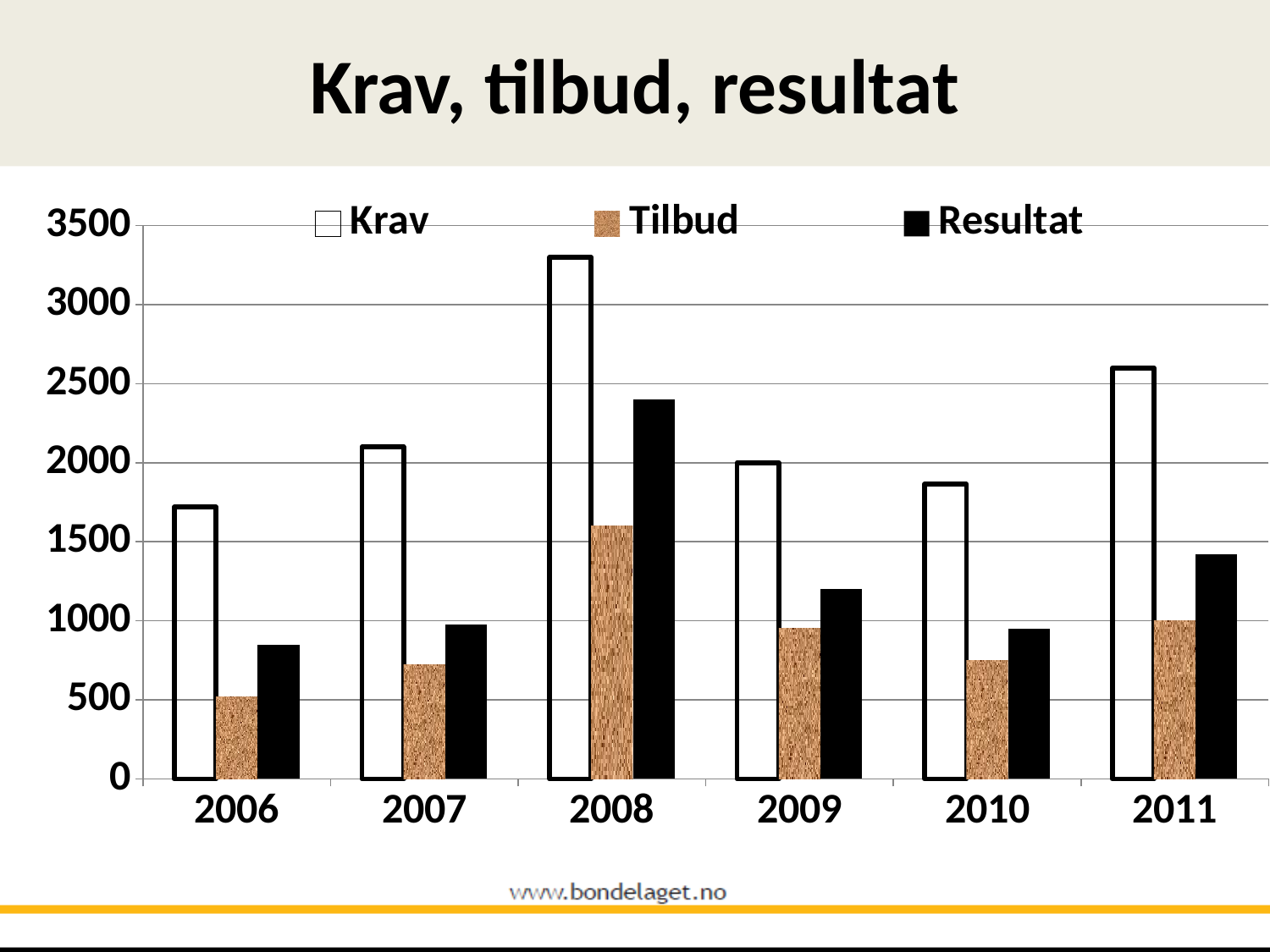
Which year has the lowest Tilbud value? 2006 Is the Resultat value for 2011 greater or less than 1500? less How many series does the legend list? 3 What is the title of the slide? Krav, tilbud, resultat Is the Krav value for 2008 greater or less than 3000? greater Which is larger in 2009, the Tilbud value or the Resultat value? Resultat What kind of chart is shown on the slide? bar chart Is the Tilbud value for 2006 greater or less than 1000? less How many years are shown on the x axis? 6 Which year has the highest Resultat value? 2008 Which year has the highest Krav value? 2008